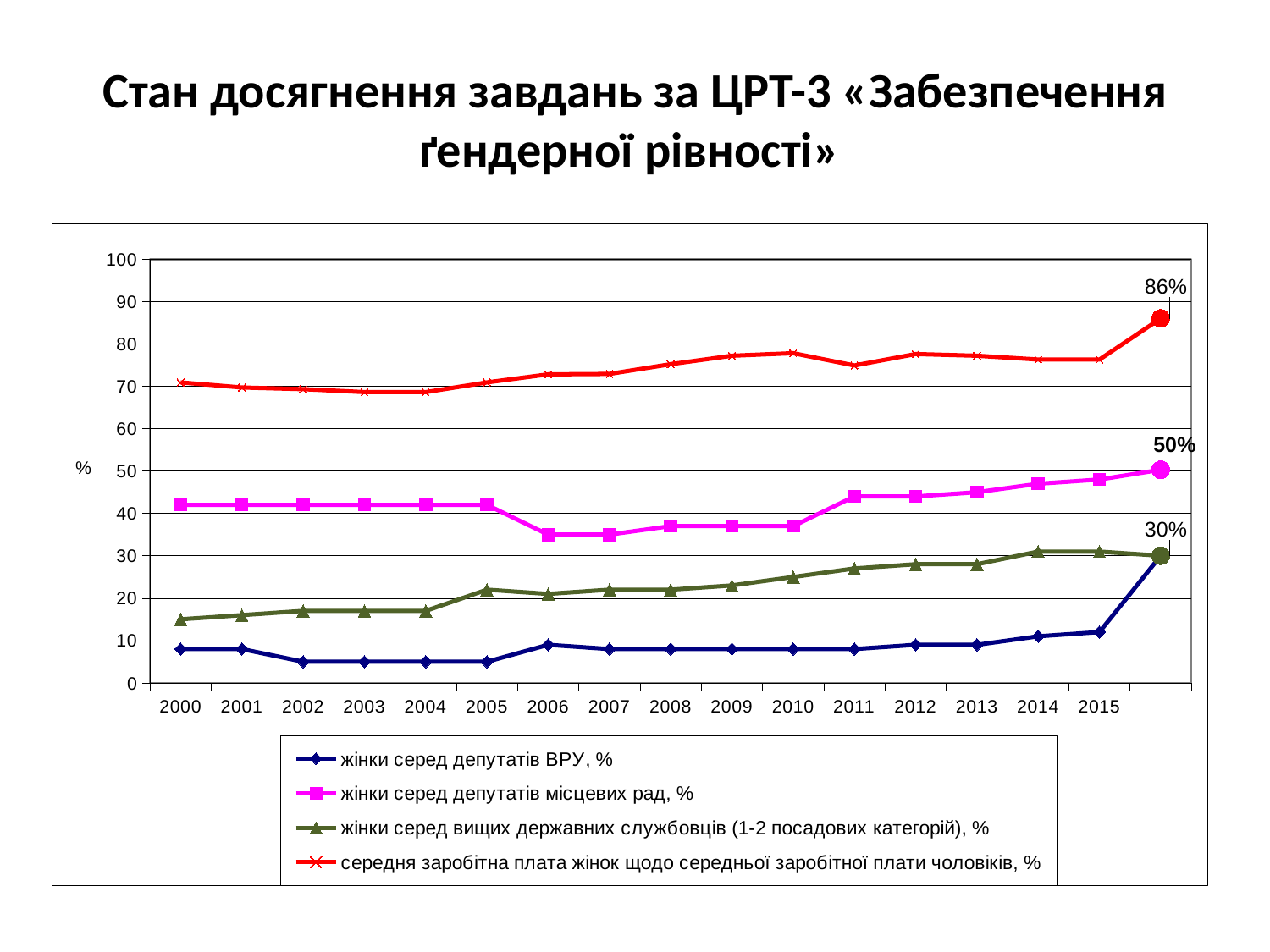
Is the value for "жінки серед депутатів ВРУ, %" in 2002 greater or less than 10? less In 2000, which series has the higher value: "середня заробітна плата жінок щодо середньої заробітної плати чоловіків, %" or "жінки серед депутатів місцевих рад, %"? середня заробітна плата жінок щодо середньої заробітної плати чоловіків, % Does the series "жінки серед вищих державних службовців (1-2 посадових категорій), %" generally rise or fall from 2000 to 2015? rise Is the value for "жінки серед депутатів місцевих рад, %" in 2000 greater or less than 40? greater How many years are labelled on the x axis? 16 Which series has the lowest value in 2000? жінки серед депутатів ВРУ, % What is the difference between the labelled final values 86% and 50%? 36% What is the labelled final value of the series "жінки серед вищих державних службовців (1-2 посадових категорій), %"? 30% What is the labelled final value of the series "жінки серед депутатів місцевих рад, %"? 50% What is the labelled final value of the series "середня заробітна плата жінок щодо середньої заробітної плати чоловіків, %"? 86% What kind of chart is shown on the slide? line chart How many series does the legend list? 4